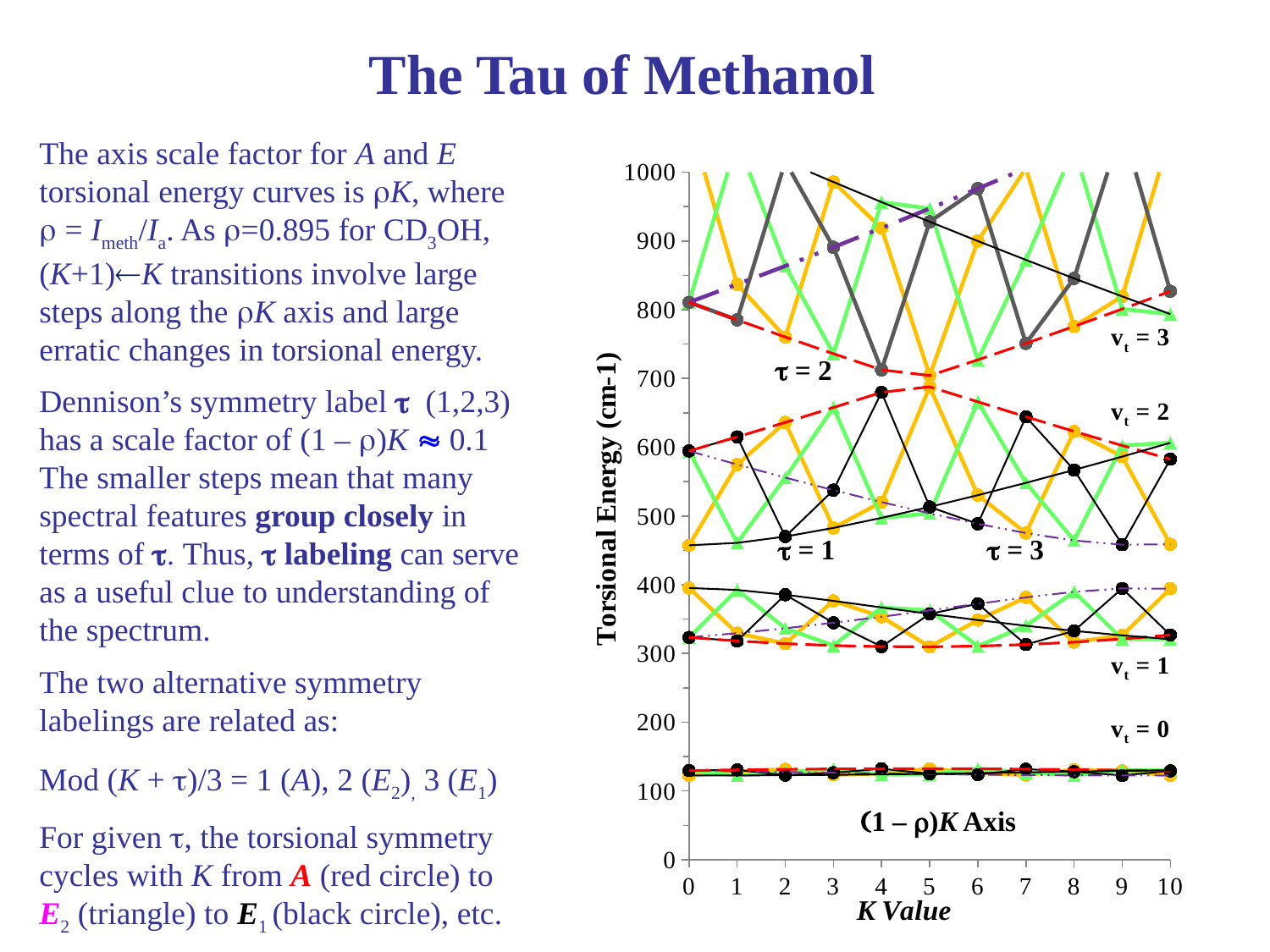
What kind of chart is shown on the slide? line chart How many K values are plotted along the x axis of the chart? 11 What is the title of the x axis of the chart? K Value Which torsional level label on the chart corresponds to the highest-energy curves? vt = 3 Which torsional level label on the chart corresponds to the lowest-energy curves? vt = 0 What is the title of the y axis of the chart? Torsional Energy (cm-1) Is the torsional energy of the grey vt = 3 black-circle point at K = 6 greater or less than 900? greater Is the torsional energy of the vt = 0 curves at K = 5 greater or less than 100? greater Is the torsional energy of the black-circle point at K = 4 in the vt = 2 group greater or less than 600? greater What is the highest tick value shown on the y axis of the chart? 1000